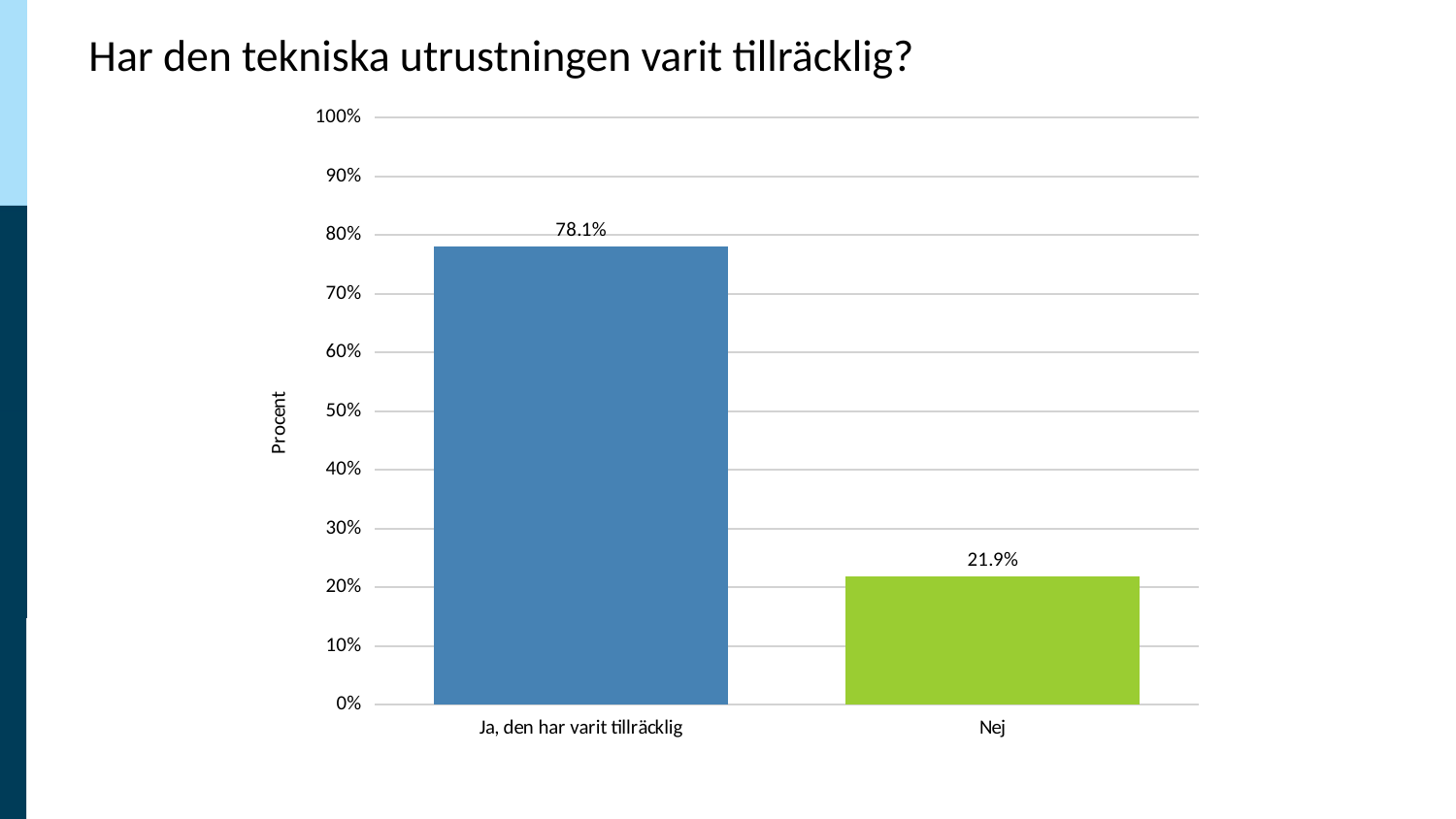
What is the difference between the values for "Ja, den har varit tillräcklig" and "Nej"? 56.2% Is the value for "Nej" greater or less than 30%? less Which is larger, the value for "Ja, den har varit tillräcklig" or the value for "Nej"? Ja, den har varit tillräcklig Which category has the highest value? Ja, den har varit tillräcklig Which category has the lowest value? Nej What is the label of the vertical axis? Procent What is the value for "Ja, den har varit tillräcklig"? 78.1% What kind of chart is shown on the slide? Bar chart What is the value for "Nej"? 21.9% Is the value for "Ja, den har varit tillräcklig" greater or less than 70%? greater What is the title of the chart? Har den tekniska utrustningen varit tillräcklig? How many categories are shown in the chart? 2